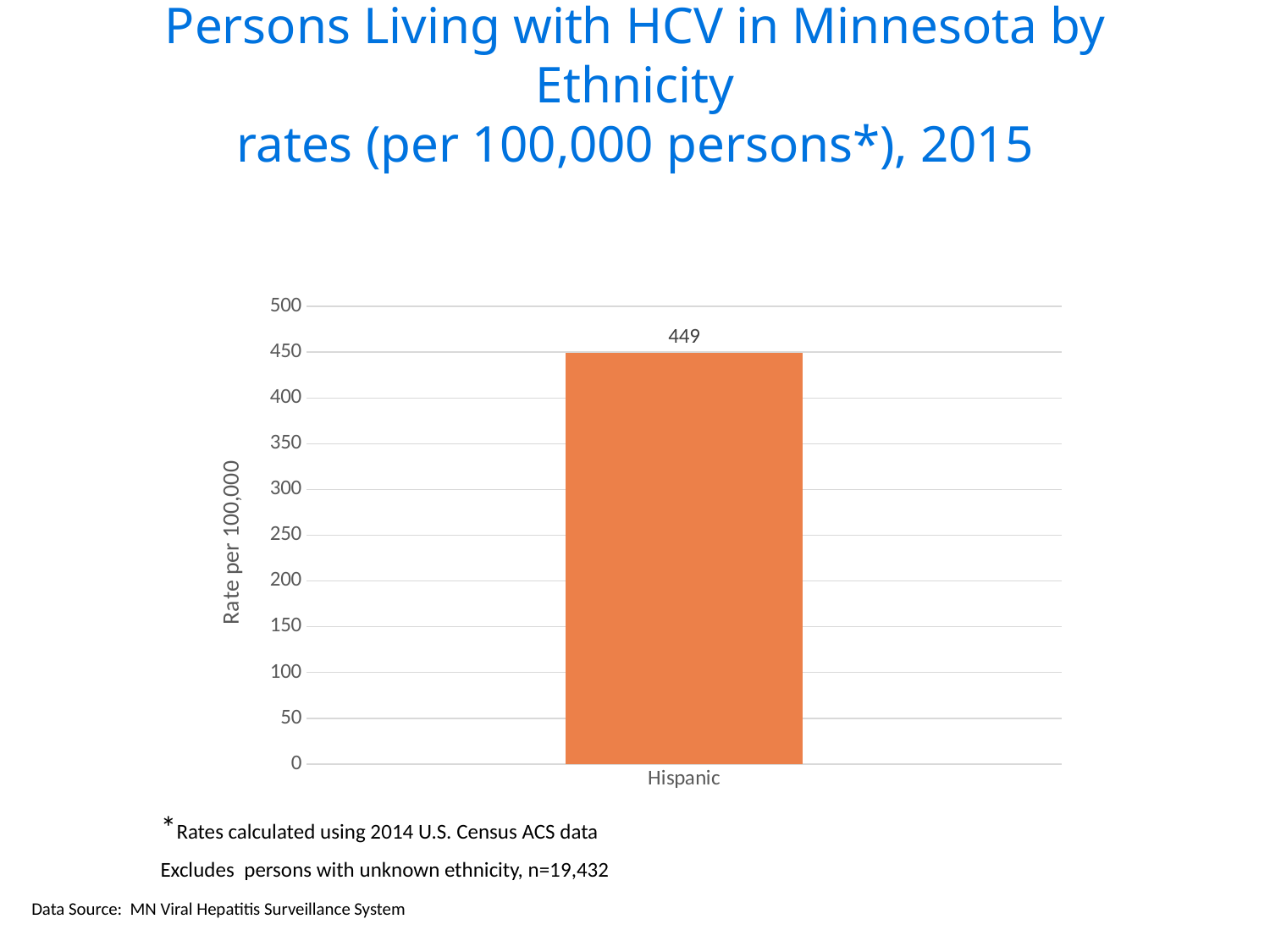
What is the rate per 100,000 for Hispanic persons living with HCV in Minnesota in 2015? 449 What is the y-axis title of the chart? Rate per 100,000 What kind of chart is shown on the slide? bar chart Is the value for Hispanic greater or less than 400? greater Is the value for Hispanic greater or less than 500? less What is the maximum value shown on the y axis? 500 What is the label of the only category on the x axis? Hispanic How many categories are plotted on the chart? 1